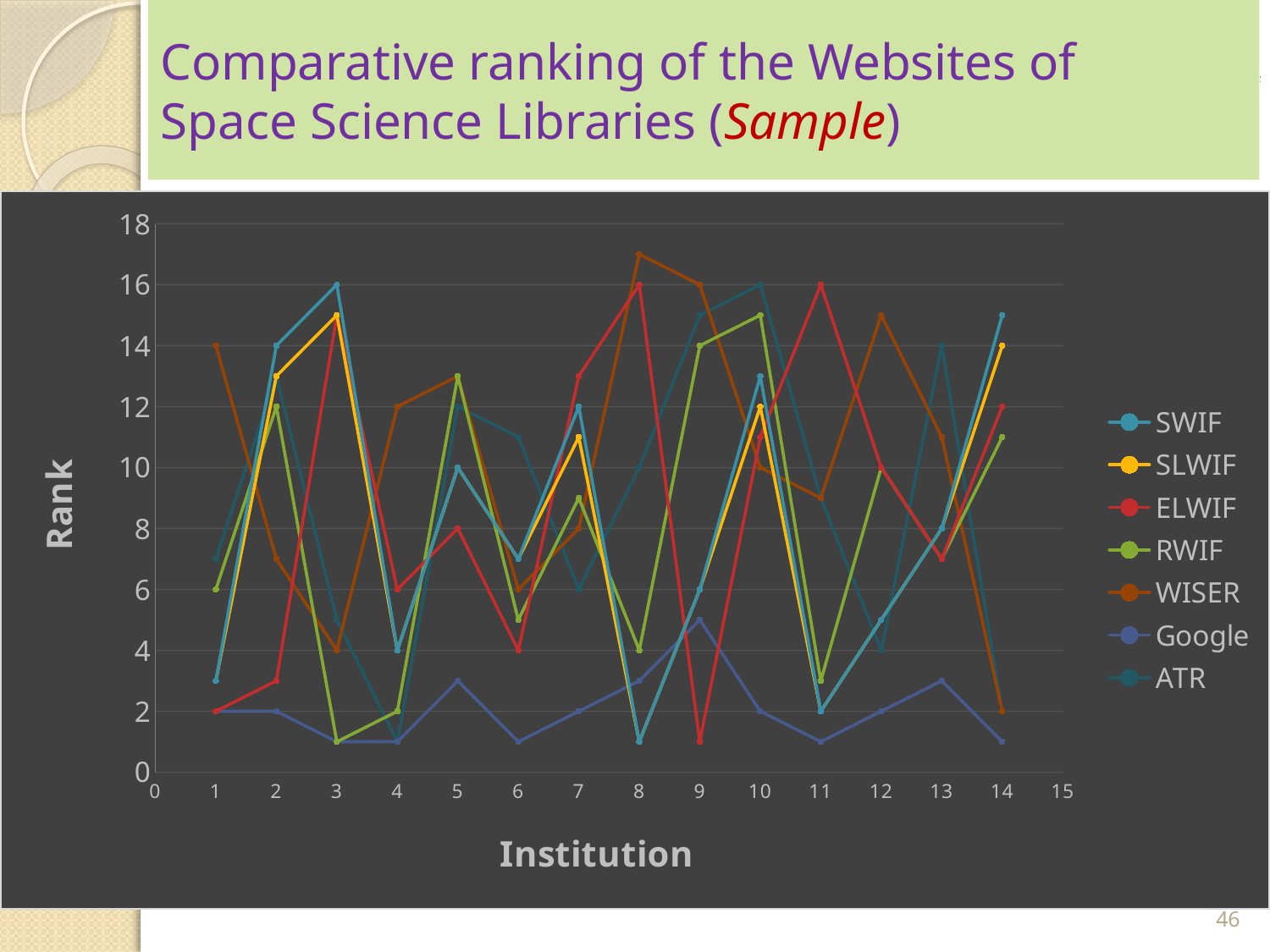
What is the rank of ELWIF at institution 8? 16 What is the rank of Google at institution 1? 2 At which institution does the Google series reach its highest rank? 9 What is the title of the y axis? Rank How many series does the legend list? 7 How many institutions are plotted along the x axis? 14 What is the difference between the WISER rank and the Google rank at institution 1? 12 At institution 8, which series has the larger rank, ELWIF or Google? ELWIF Is the Google rank at institution 5 greater or less than 6? less What is the rank of WISER at institution 1? 14 What kind of chart is shown on the slide? line chart What is the title of the x axis? Institution